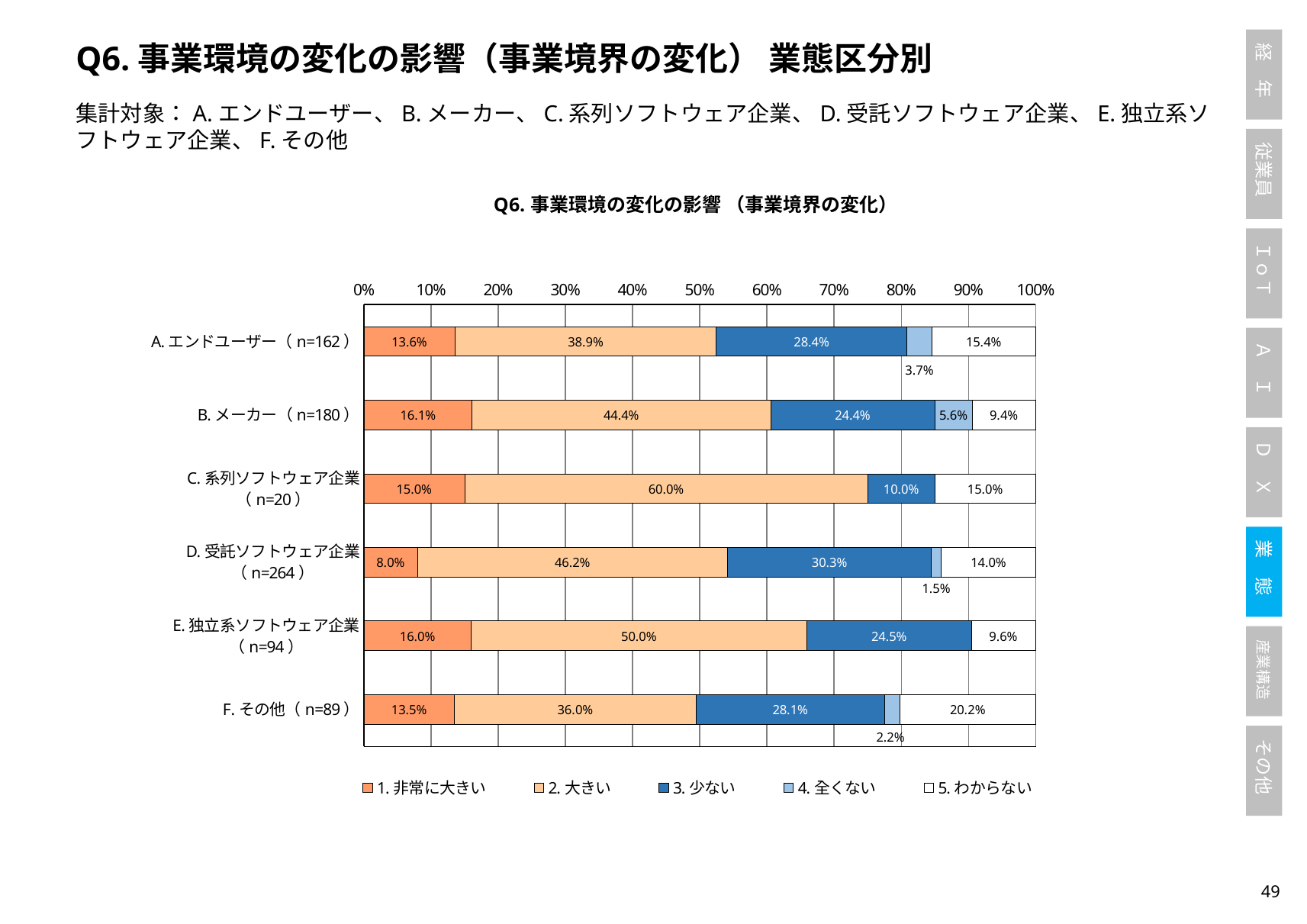
What type of chart is shown on the slide? Stacked bar chart What is the value of 「4. 全くない」 for B. メーカー? 5.6% How many categories (業態区分) are plotted on the chart? 6 Which is larger: the 「5. わからない」 value for A. エンドユーザー or for B. メーカー? A. エンドユーザー How many series does the legend list? 5 Which category has the highest value for 「2. 大きい」? C. 系列ソフトウェア企業 What is the value of 「2. 大きい」 for C. 系列ソフトウェア企業? 60.0% What is the value of 「1. 非常に大きい」 for D. 受託ソフトウェア企業? 8.0% What is the value of 「5. わからない」 for F. その他? 20.2% Which category has the lowest value for 「1. 非常に大きい」? D. 受託ソフトウェア企業 What is the difference between the 「3. 少ない」 values for D. 受託ソフトウェア企業 and C. 系列ソフトウェア企業? 20.3% What is the sample size (n) shown for D. 受託ソフトウェア企業? 264